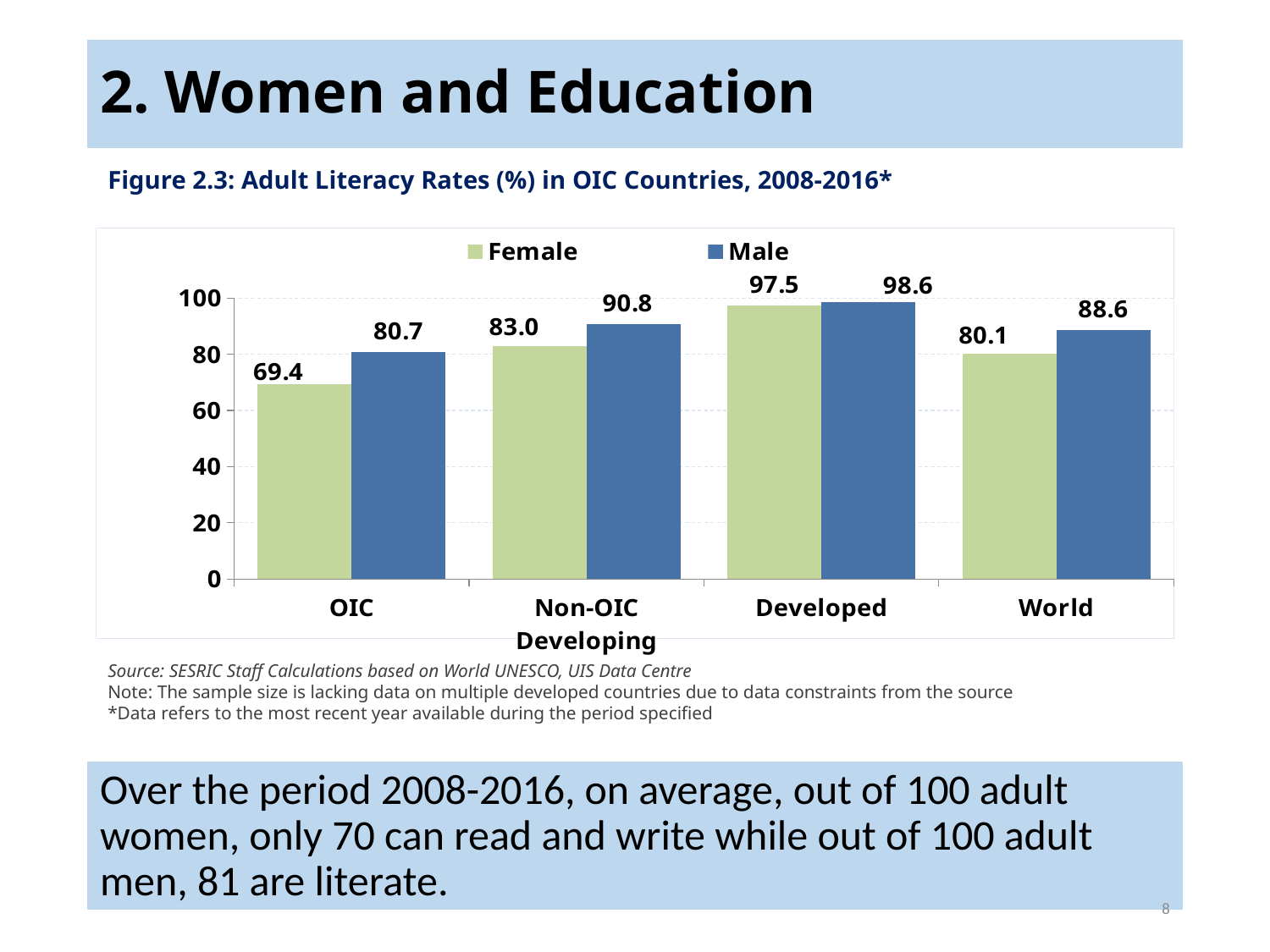
Which category has the lowest Female literacy rate? OIC What is the Female adult literacy rate for the World? 80.1 Which colour represents the Male series in the chart? Blue What kind of chart is shown on the slide? Bar chart Which is larger: the Male literacy rate for the World or the Female literacy rate for Non-OIC Developing countries? Male literacy rate for the World How many series does the legend list? 2 What is the difference between the Female literacy rate in Developed countries and in OIC countries? 28.1 Which category has the highest Male literacy rate? Developed What is the difference between the Male and Female literacy rates in OIC countries? 11.3 What is the Female adult literacy rate for OIC countries? 69.4 How many categories are shown on the x axis? 4 What is the Male adult literacy rate for Non-OIC Developing countries? 90.8